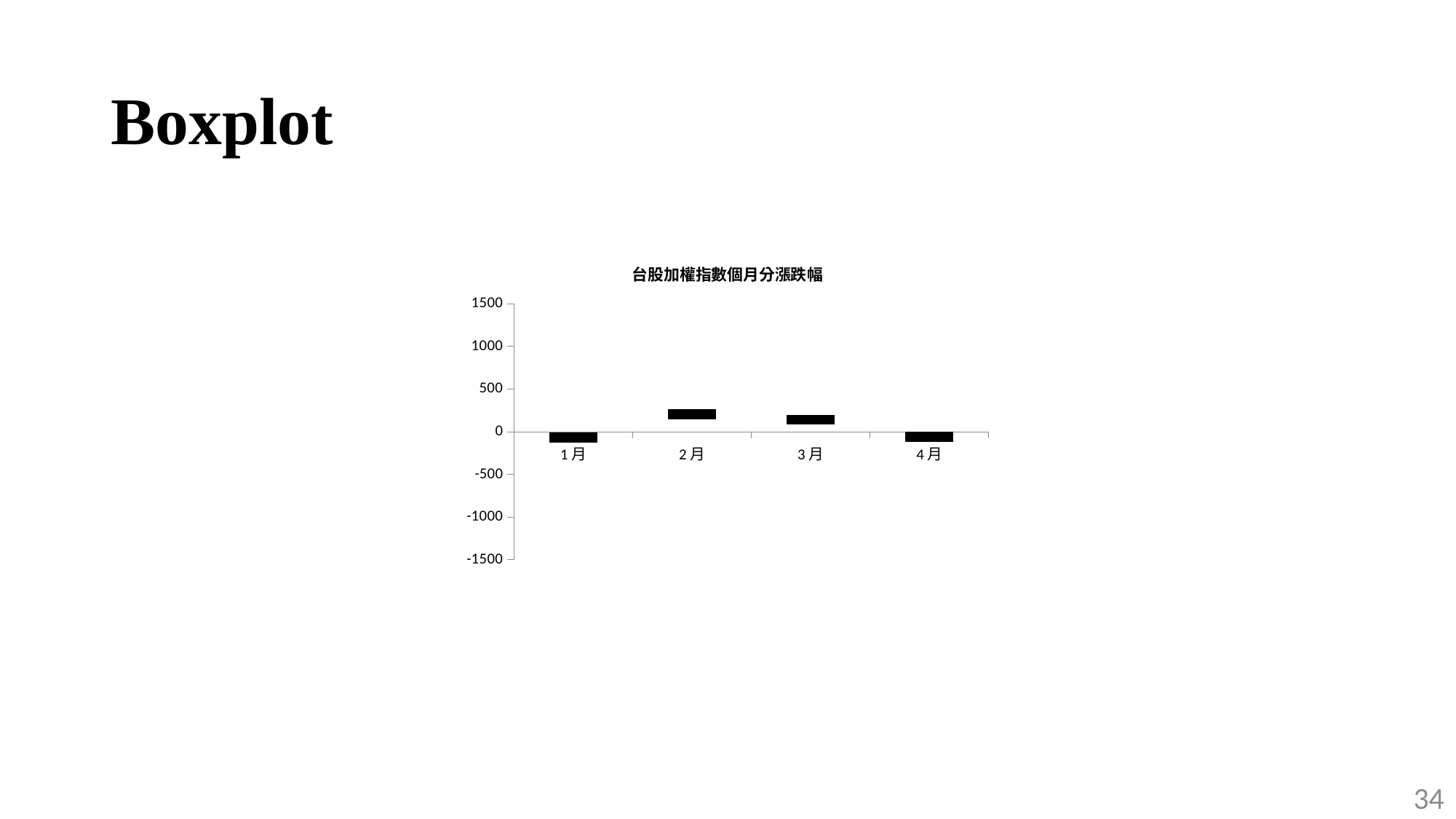
Which month has the highest value in the chart? 2月 Is the value for 4月 greater or less than -500? greater What kind of chart is shown on the slide? boxplot How many months are shown on the x axis of the chart? 4 Is the value for 3月 greater or less than 500? less Is the value for 2月 greater or less than 0? greater Which is larger, the value for 2月 or the value for 4月? 2月 Which is larger, the value for 3月 or the value for 1月? 3月 What is the title of the chart? 台股加權指數個月分漲跌幅 What is the highest tick value shown on the y axis of the chart? 1500